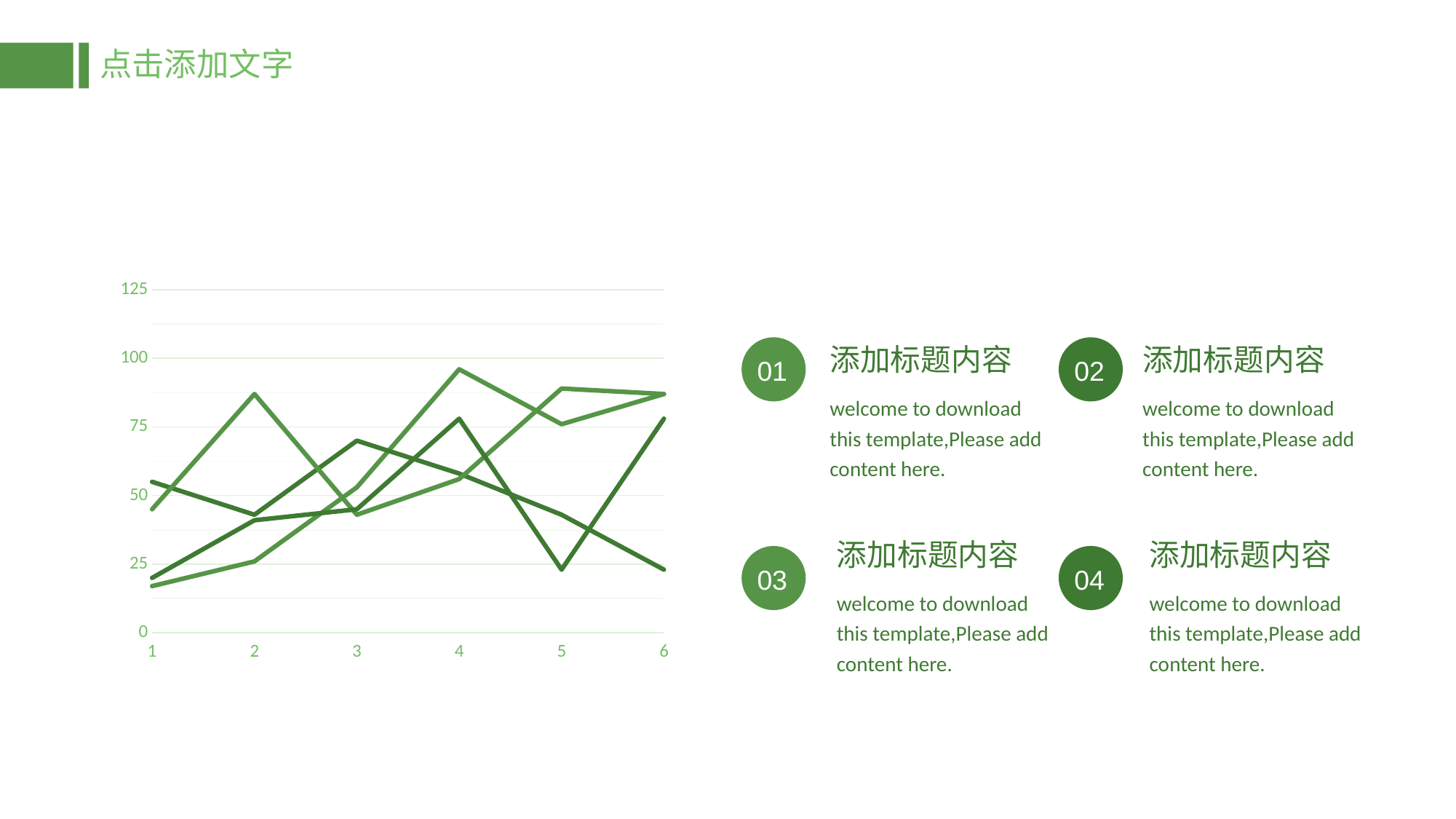
What is the first label on the x axis of the chart? 1 Is the lowest point reached by any line on the chart greater or less than 25? less What is the highest value labelled on the y axis of the chart? 125 Is the highest point reached by any line on the chart greater or less than 100? less What kind of chart is shown on the slide? line chart How many points are labelled along the x axis of the chart? 6 Does any line on the chart rise above 100? No How many lines are plotted on the chart? 4 What is the last label on the x axis of the chart? 6 What is the lowest value labelled on the y axis of the chart? 0